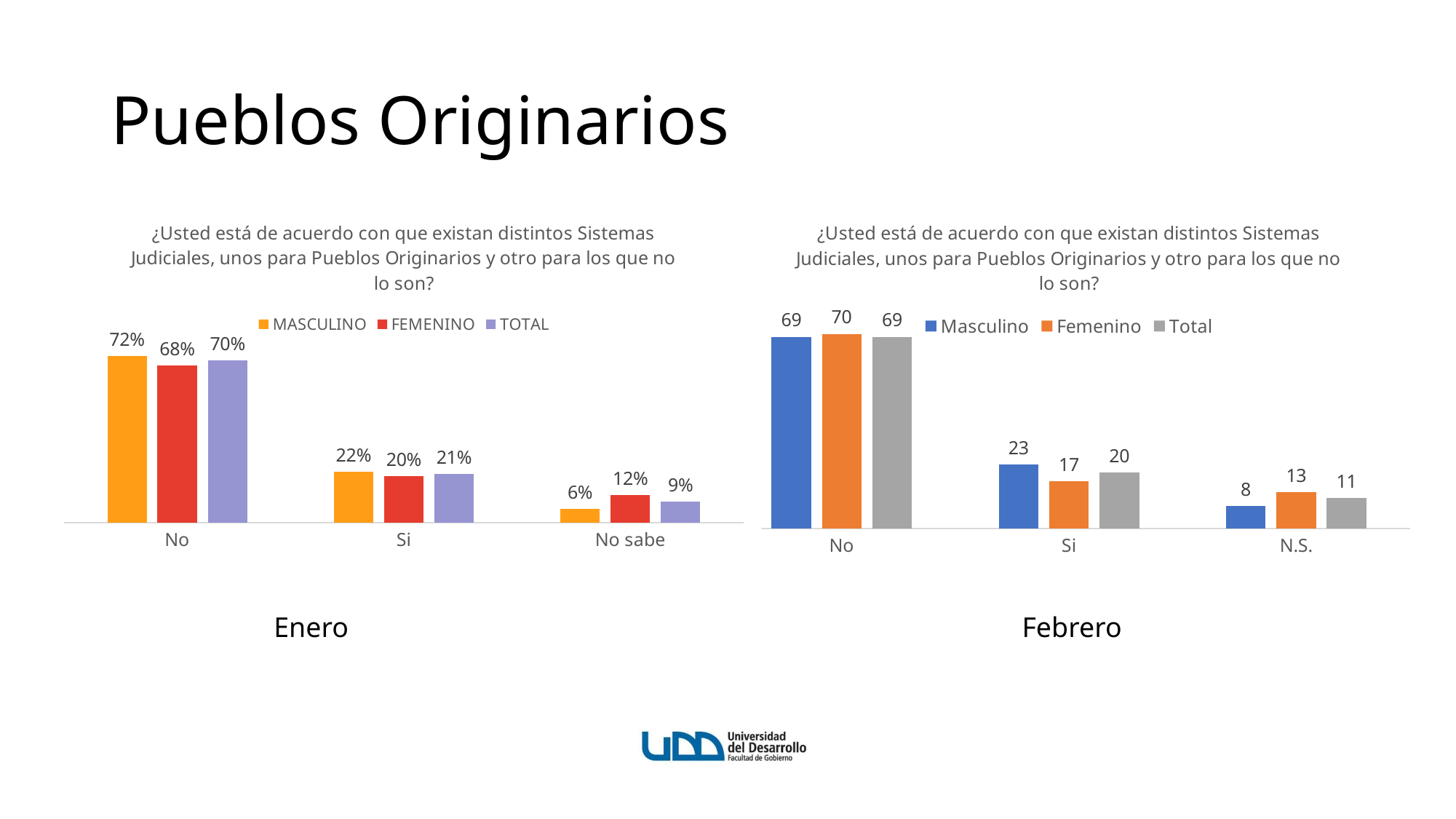
How many series does the legend of the Febrero chart list? 3 In the Febrero chart, which category has the lowest Masculino value? N.S. In the Enero chart, what is the MASCULINO value for No? 72% In the Febrero chart, what is the Femenino value for Si? 17 In the Enero chart, which category has the highest TOTAL value? No In the Febrero chart, what is the Total value for N.S.? 11 In the Enero chart, what is the difference between the MASCULINO and FEMENINO values for No? 4% In the Febrero chart, which is larger for N.S.: Masculino or Femenino? Femenino In the Enero chart, what is the FEMENINO value for No sabe? 12% What kind of chart is the Enero chart? Bar chart How many categories are shown on the x axis of the Enero chart? 3 In the Febrero chart, what is the difference between the Masculino and Femenino values for Si? 6